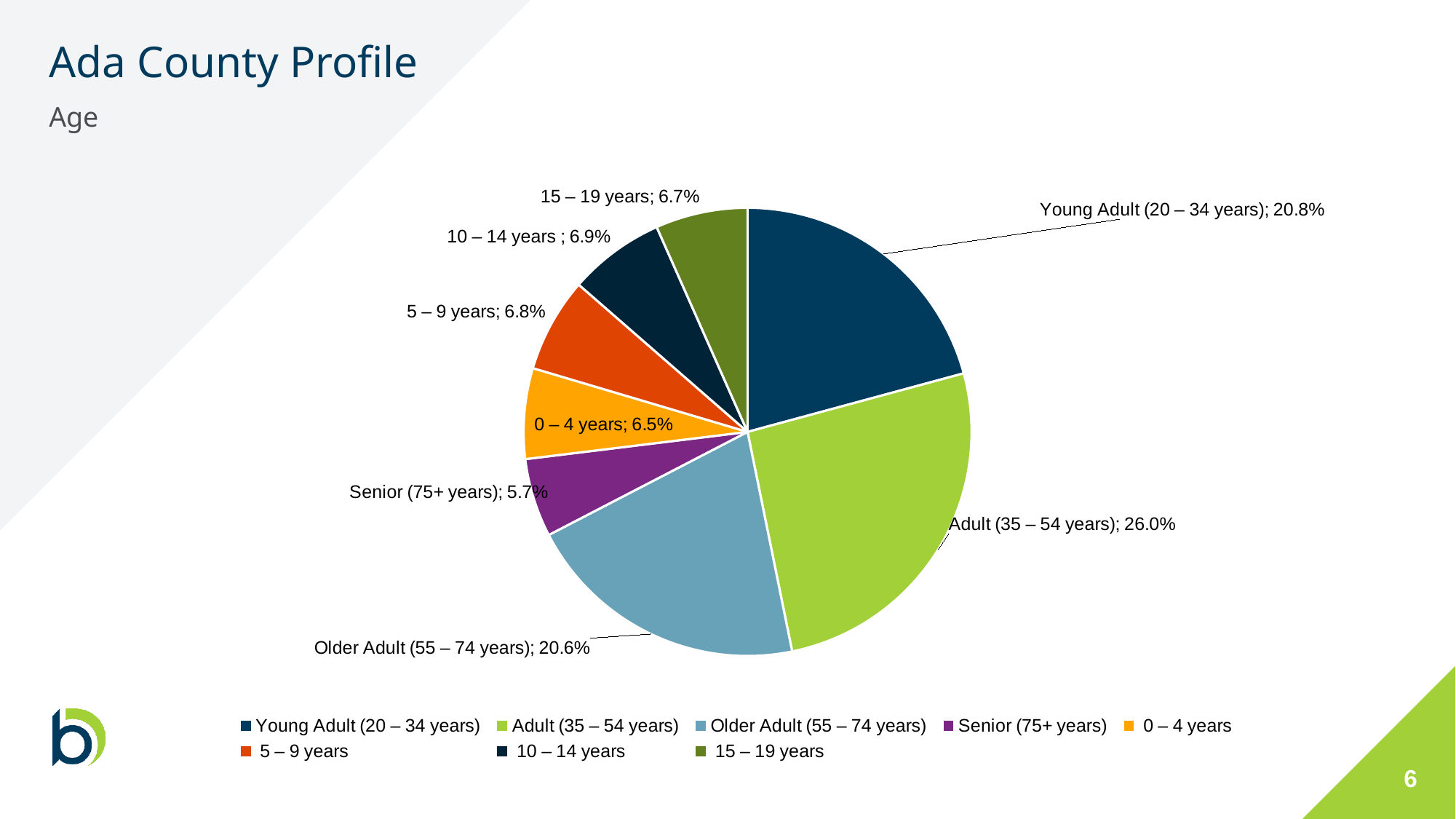
What share of the pie is Adult (35 – 54 years)? 26.0% Which is larger, the share for 10 – 14 years or the share for 0 – 4 years? 10 – 14 years What kind of chart is shown on the slide? pie chart What is the value for Young Adult (20 – 34 years)? 20.8% What is the value for Senior (75+ years)? 5.7% What is the subtitle shown under the slide title 'Ada County Profile'? Age What is the difference between the shares for Adult (35 – 54 years) and Older Adult (55 – 74 years)? 5.4% What is the value for 0 – 4 years? 6.5% Which age group has the largest share of the pie? Adult (35 – 54 years) Which age group has the smallest share of the pie? Senior (75+ years) How many slices does the pie chart have? 8 How many entries does the legend list? 8